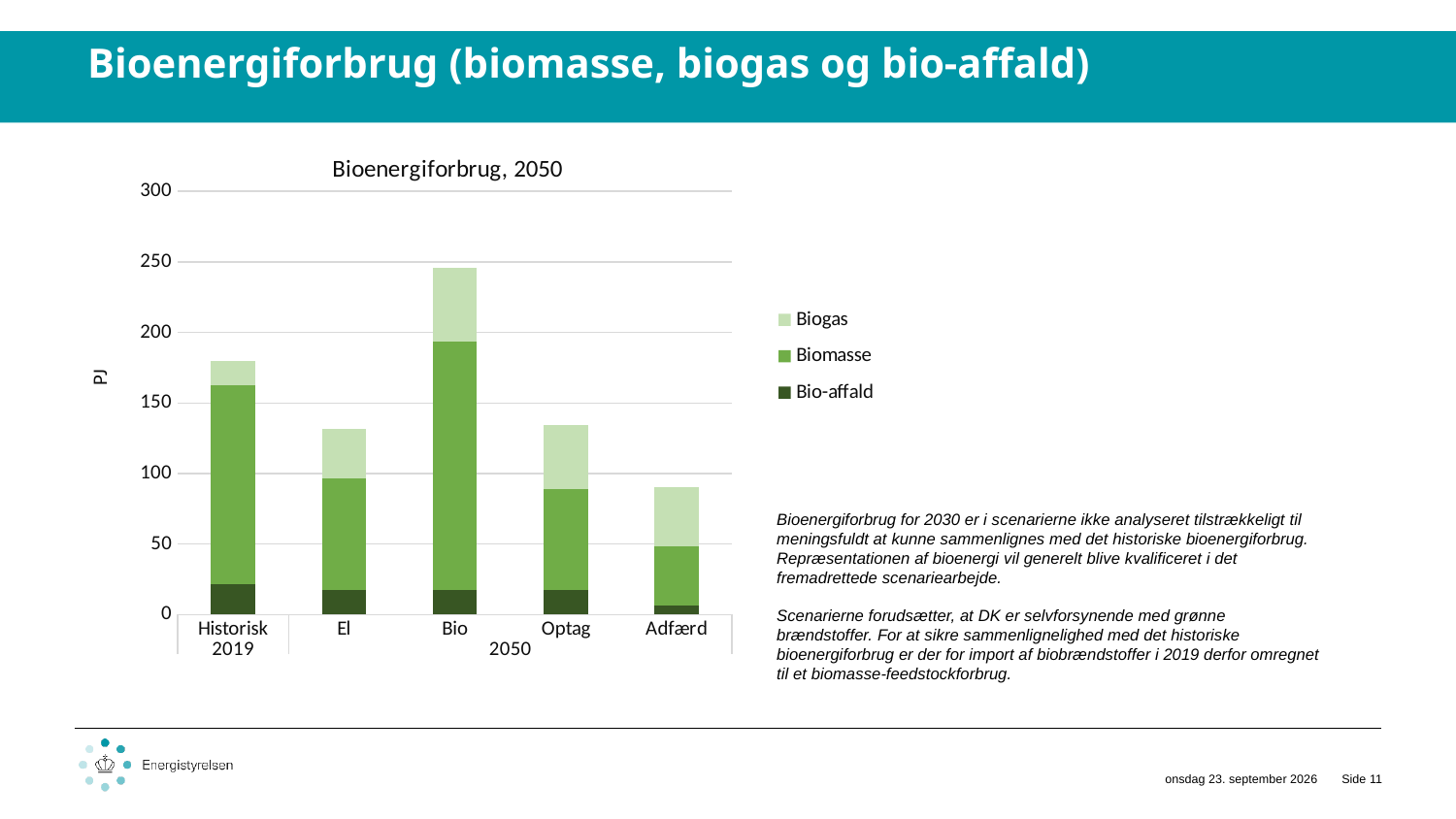
Which category has the shortest stacked bar? Adfærd How many categories are shown along the x axis of the chart? 5 What is the title of the chart? Bioenergiforbrug, 2050 What unit is shown on the y axis of the chart? PJ Is the total value for El greater or less than 100? greater Which has the larger total bar, Historisk 2019 or El? Historisk 2019 What kind of chart is shown on the slide? Stacked bar chart Which category has the tallest stacked bar? Bio How many series does the legend list? 3 Is the total value for Historisk 2019 greater or less than 150? greater Is the total value for Bio greater or less than 250? less